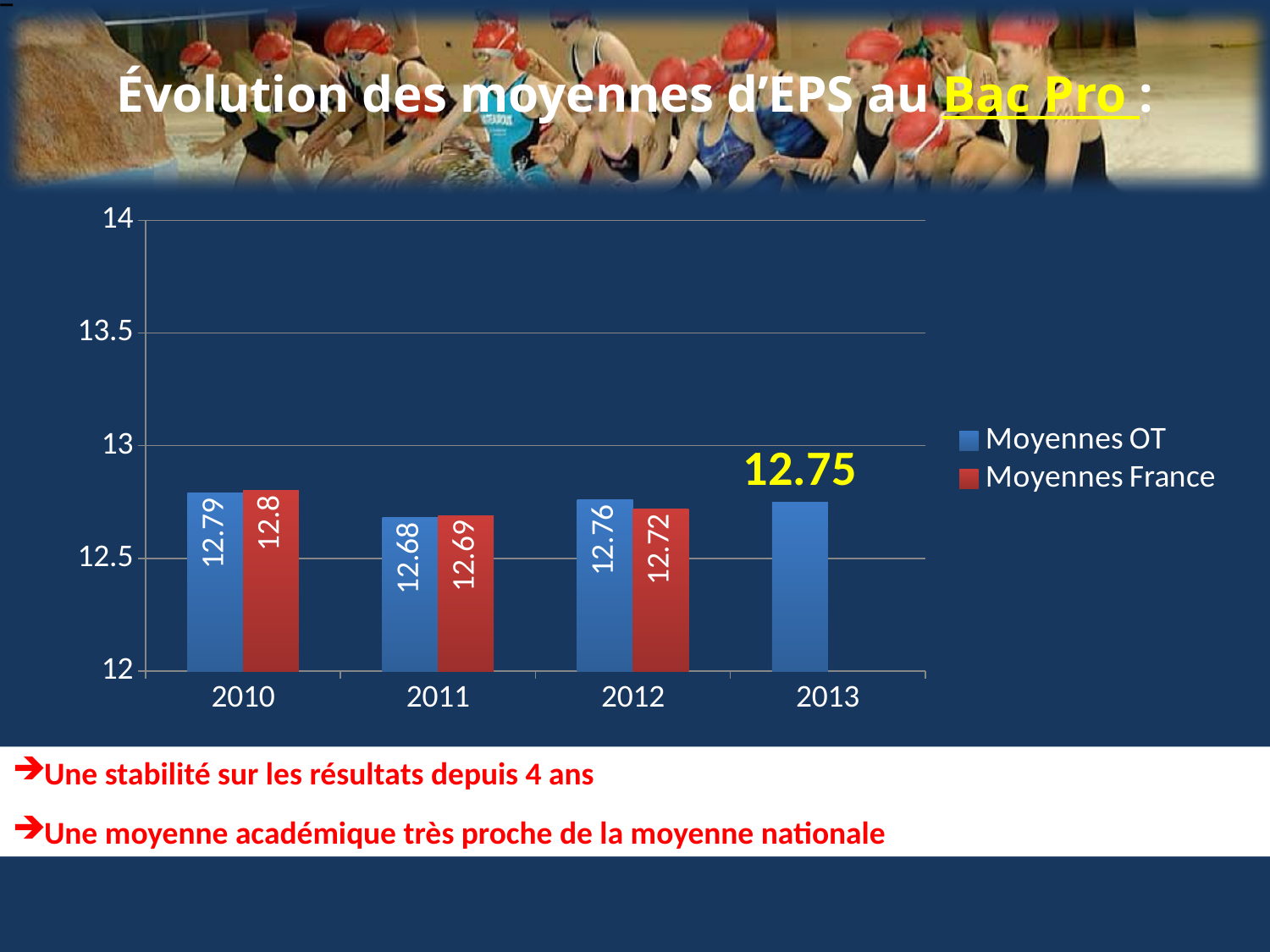
What is the difference between Moyennes OT and Moyennes France in 2012? 0.04 Which is larger in 2010, Moyennes OT or Moyennes France? Moyennes France In which year is Moyennes OT the lowest? 2011 How many years are shown on the x axis? 4 What is the value of Moyennes OT for 2013? 12.75 In which year is Moyennes France the highest? 2010 What is the value of Moyennes France for 2011? 12.69 How many series does the legend list? 2 What kind of chart is shown on the slide? Bar chart Which year has no Moyennes France bar? 2013 What is the value of Moyennes OT for 2010? 12.79 What is the value of Moyennes France for 2012? 12.72